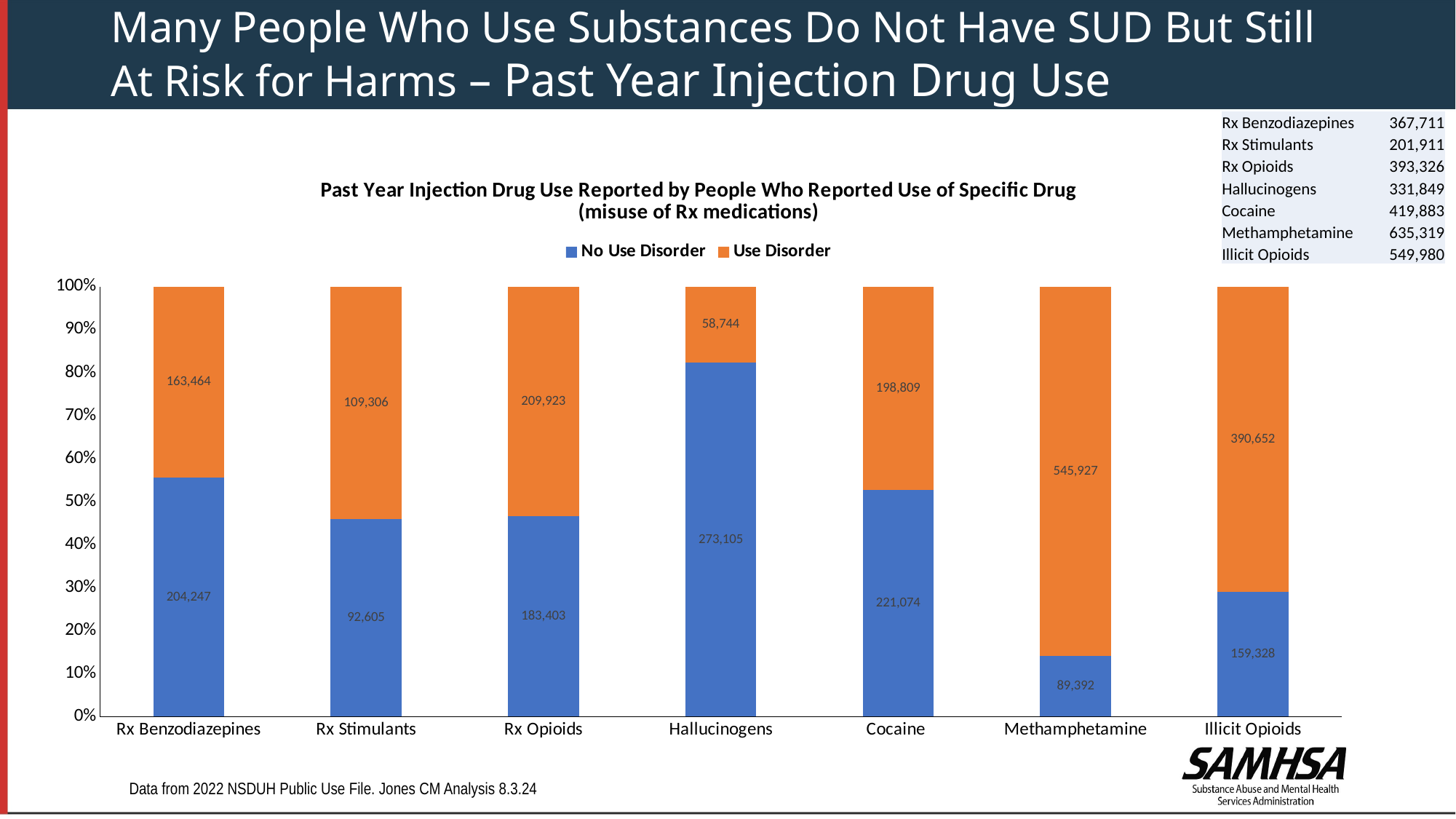
Which drug category has the highest Use Disorder value? Methamphetamine Is the No Use Disorder share of the Methamphetamine bar greater or less than 20%? less What kind of chart is shown? Stacked bar chart What is the No Use Disorder value for Hallucinogens? 273,105 Which is larger for Cocaine: the No Use Disorder value or the Use Disorder value? No Use Disorder What is the Use Disorder value for Methamphetamine? 545,927 Which drug category has the lowest Use Disorder value? Hallucinogens How many drug categories are shown on the x axis? 7 What is the total of the Rx Opioids bar (No Use Disorder plus Use Disorder)? 393,326 What is the difference between the Use Disorder and No Use Disorder values for Methamphetamine? 456,535 What is the No Use Disorder value for Rx Stimulants? 92,605 How many series does the legend list? 2